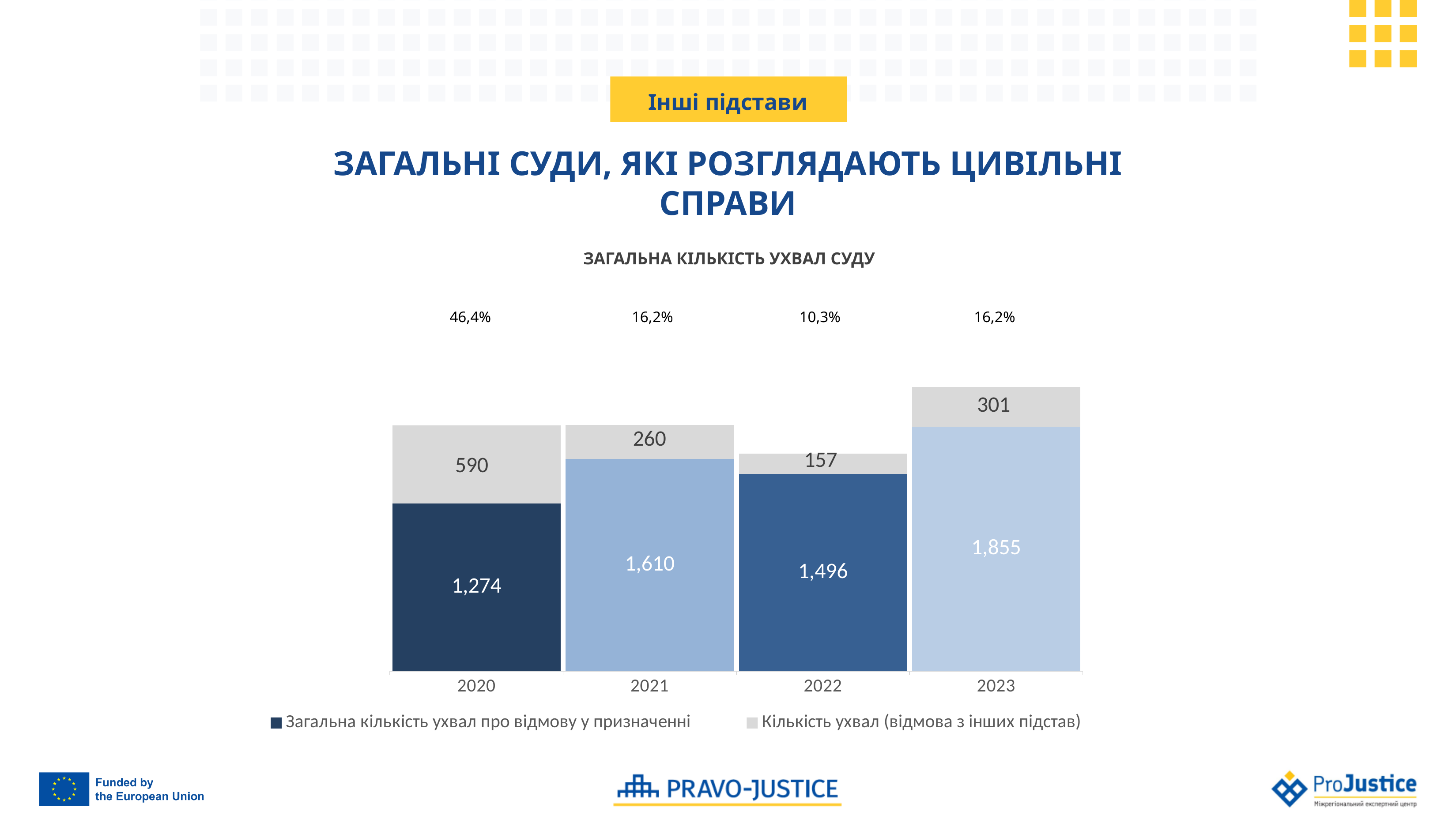
What percentage is shown above the 2022 bar? 10,3% What type of chart is shown on the slide? Stacked bar chart Which year has the highest value for 'Загальна кількість ухвал про відмову у призначенні'? 2023 What is the total of the stacked bar for 2020? 1,864 What is the value of 'Загальна кількість ухвал про відмову у призначенні' for 2021? 1,610 Which is larger: the 'Кількість ухвал (відмова з інших підстав)' value for 2021 or for 2023? 2023 Which year has the lowest value for 'Кількість ухвал (відмова з інших підстав)'? 2022 What is the value of 'Кількість ухвал (відмова з інших підстав)' for 2020? 590 How many years are shown on the x axis of the chart? 4 What is the difference between the 'Загальна кількість ухвал про відмову у призначенні' values for 2023 and 2022? 359 What is the value of 'Кількість ухвал (відмова з інших підстав)' for 2023? 301 How many series does the chart legend list? 2